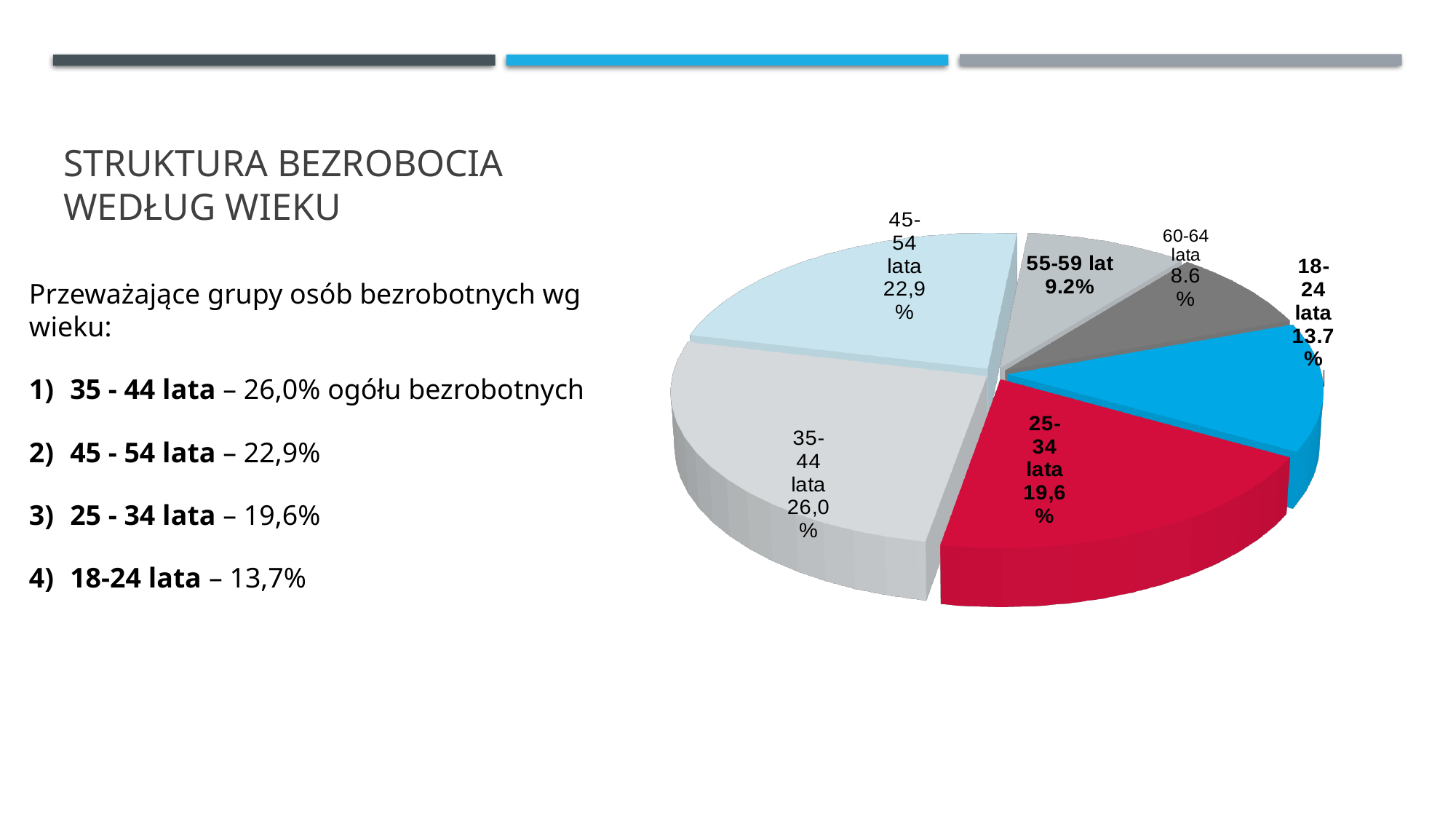
How many slices does the pie chart have? 6 What is the value shown for the 55-59 lat slice? 9.2% What is the value shown for the 60-64 lata slice? 8.6% Which age group has the largest slice of the pie? 35-44 lata What is the value shown for the 18-24 lata slice? 13.7% What is the value shown for the 25-34 lata slice? 19,6% What colour is the 25-34 lata slice? red Which slice is larger, 25-34 lata or 18-24 lata? 25-34 lata What is the value shown for the 45-54 lata slice? 22,9% What kind of chart is shown on the slide? pie chart What share of the pie does the 35-44 lata slice have? 26,0% Which age group has the smallest slice of the pie? 60-64 lata